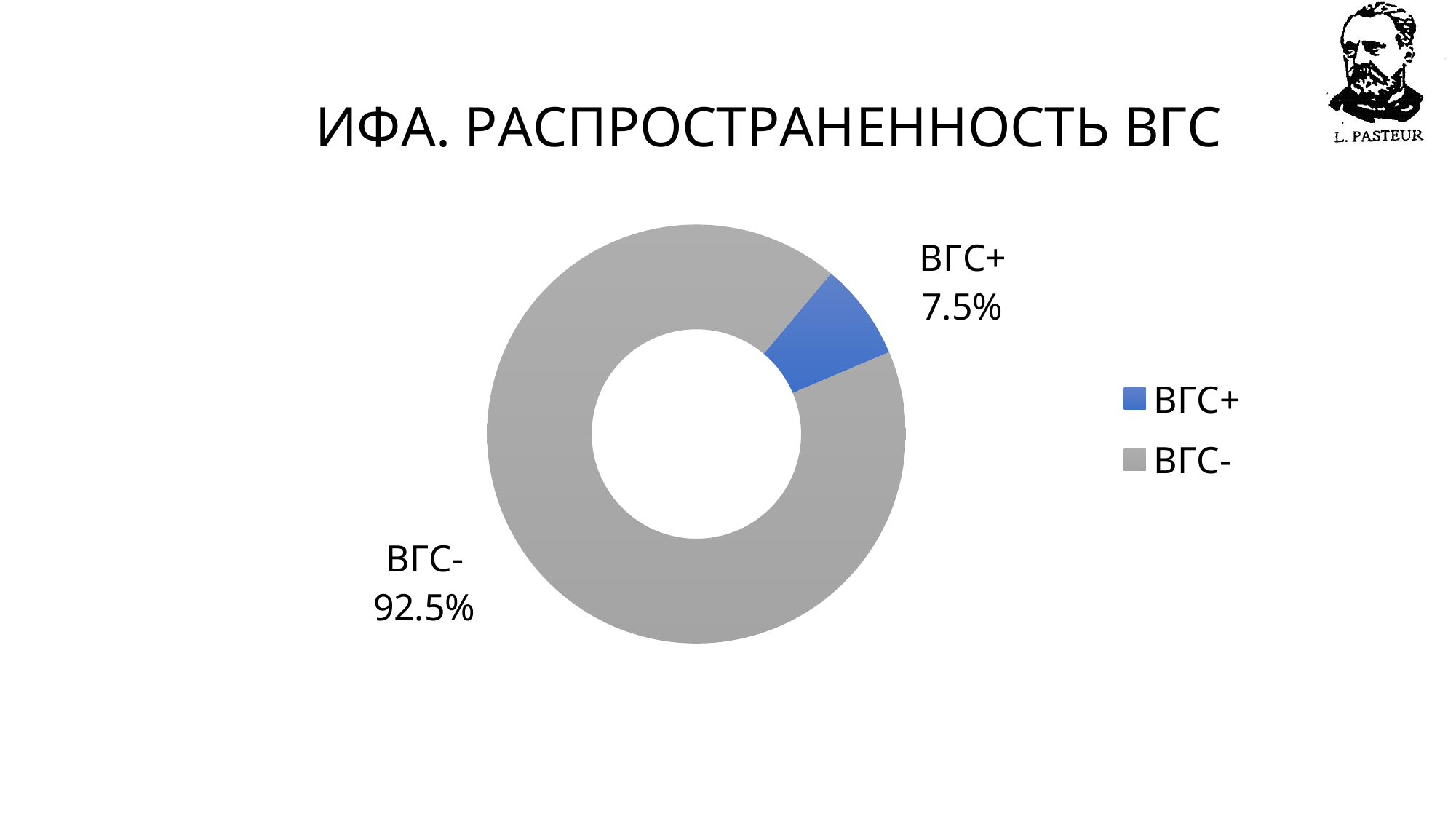
What is the title of the slide? ИФА. РАСПРОСТРАНЕННОСТЬ ВГС Which category has the largest share in the chart? ВГС- What is the difference in percentage points between the ВГС- and ВГС+ shares? 85 Which category has the smallest share in the chart? ВГС+ What share of the chart does the ВГС+ slice represent? 7.5% How many entries does the legend list? 2 What share of the chart does the ВГС- slice represent? 92.5% Which is larger, the share for ВГС+ or the share for ВГС-? ВГС- How many categories are shown in the chart? 2 What kind of chart is shown on the slide? Doughnut (pie) chart What colour is the ВГС+ slice in the chart? Blue